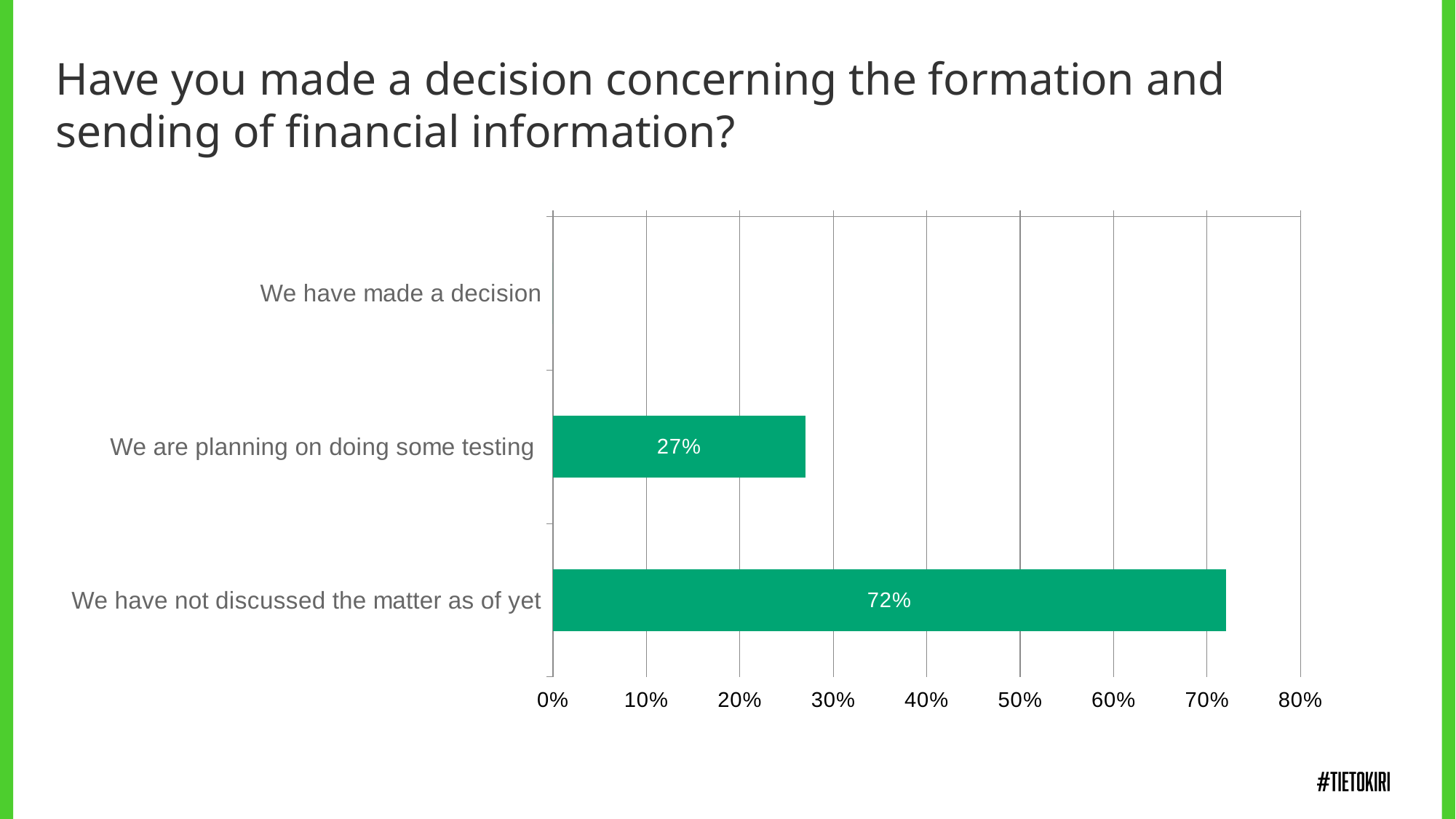
Which is larger: the value for "We are planning on doing some testing" or the value for "We have not discussed the matter as of yet"? We have not discussed the matter as of yet What is the value for "We have not discussed the matter as of yet"? 72% Is the value for "We have not discussed the matter as of yet" greater or less than 50%? greater What is the title of the slide? Have you made a decision concerning the formation and sending of financial information? What is the highest value shown on the horizontal axis? 80% What is the value for "We are planning on doing some testing"? 27% Which category has the lowest value? We have made a decision What kind of chart is shown on the slide? Bar chart What is the difference between the values for "We have not discussed the matter as of yet" and "We are planning on doing some testing"? 45 percentage points Which category has the highest value? We have not discussed the matter as of yet Is the value for "We are planning on doing some testing" greater or less than 30%? less How many categories are shown on the chart? 3